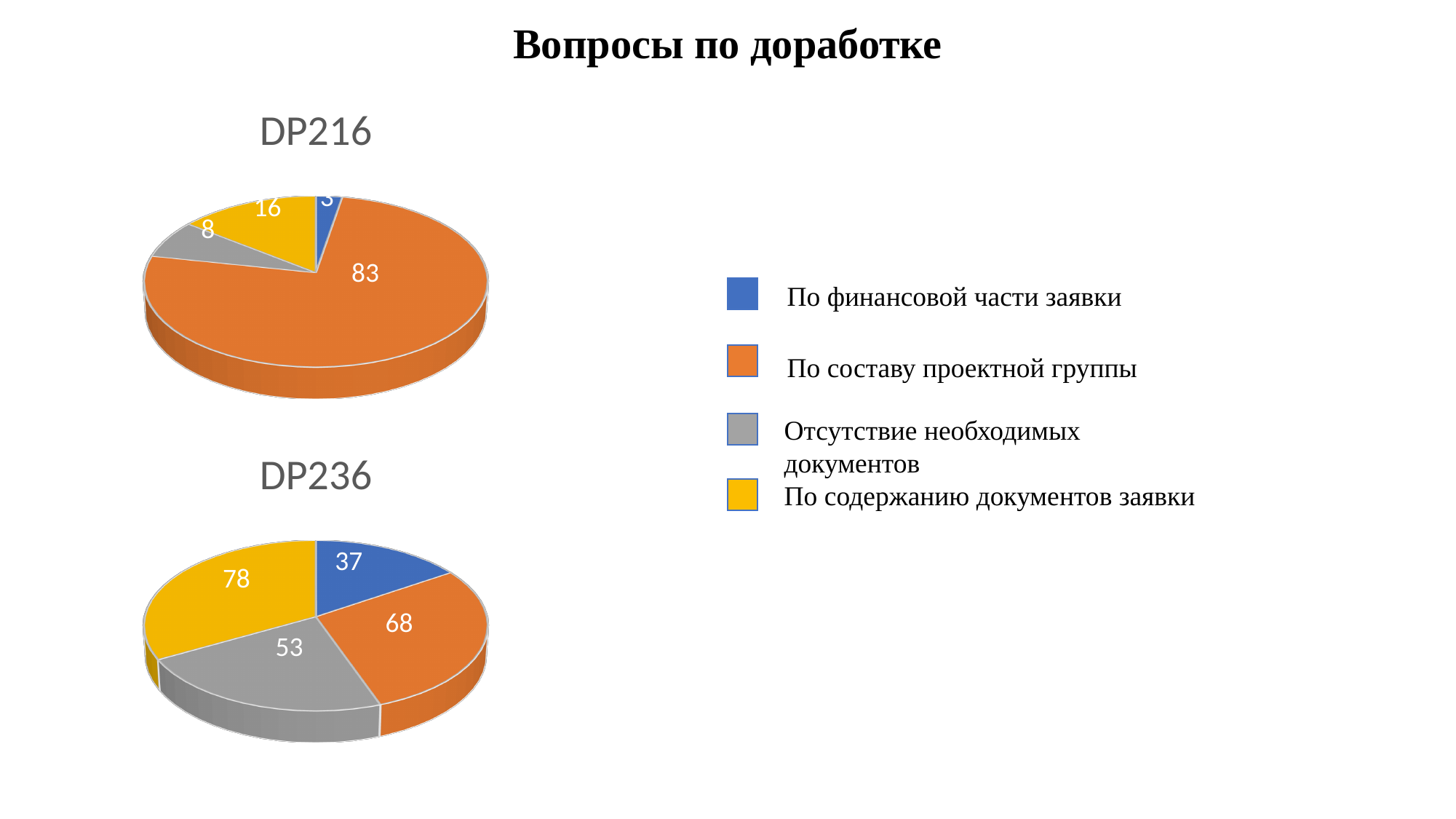
In the DP236 chart, what is the value for По содержанию документов заявки? 78 In the DP236 chart, which is larger: По составу проектной группы or Отсутствие необходимых документов? По составу проектной группы In the DP216 chart, what is the difference between По содержанию документов заявки and Отсутствие необходимых документов? 8 In the DP216 chart, what is the value for По составу проектной группы? 83 In the DP236 chart, what is the value for По финансовой части заявки? 37 In the DP236 chart, what is the difference between По содержанию документов заявки and По финансовой части заявки? 41 In the DP216 chart, what is the value for Отсутствие необходимых документов? 8 What type of chart is the DP236 chart? Pie chart In the DP236 chart, which category has the largest slice? По содержанию документов заявки In the DP216 chart, what is the value for По содержанию документов заявки? 16 In the DP236 chart, which category has the smallest slice? По финансовой части заявки In the DP216 chart, which category has the largest slice? По составу проектной группы